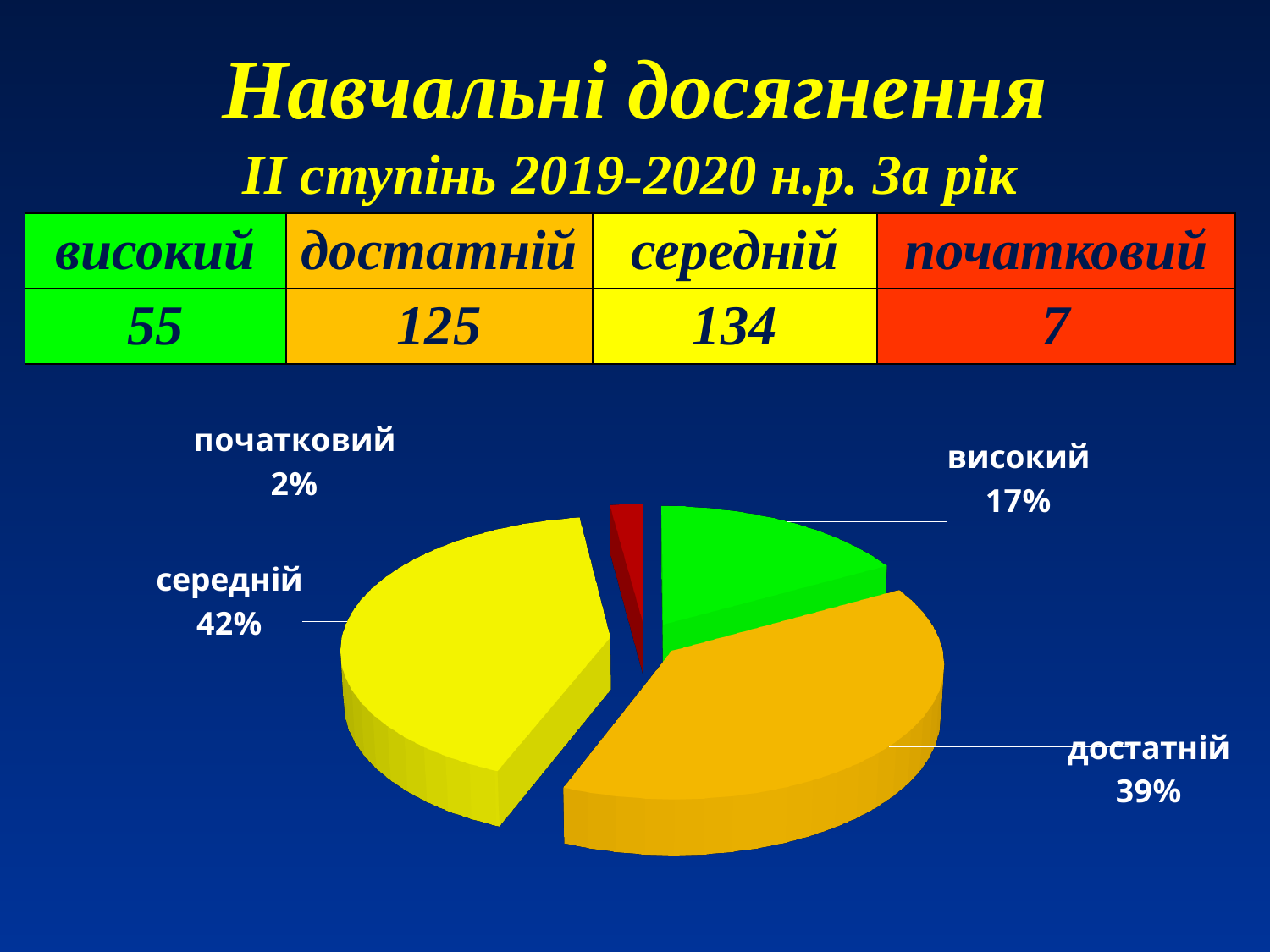
What percentage share does the 'високий' slice have in the pie chart? 17% What percentage share does the 'початковий' slice have in the pie chart? 2% What percentage share does the 'середній' slice have in the pie chart? 42% Which slice is larger in the pie chart, 'високий' or 'достатній'? достатній Which category has the largest slice in the pie chart? середній What is the difference in percentage points between the 'середній' and 'достатній' slices? 3% Which category has the smallest slice in the pie chart? початковий What colour is the 'середній' slice in the pie chart? yellow How many slices does the pie chart have? 4 What colour is the 'початковий' slice in the pie chart? dark red What kind of chart is shown on the slide? pie chart